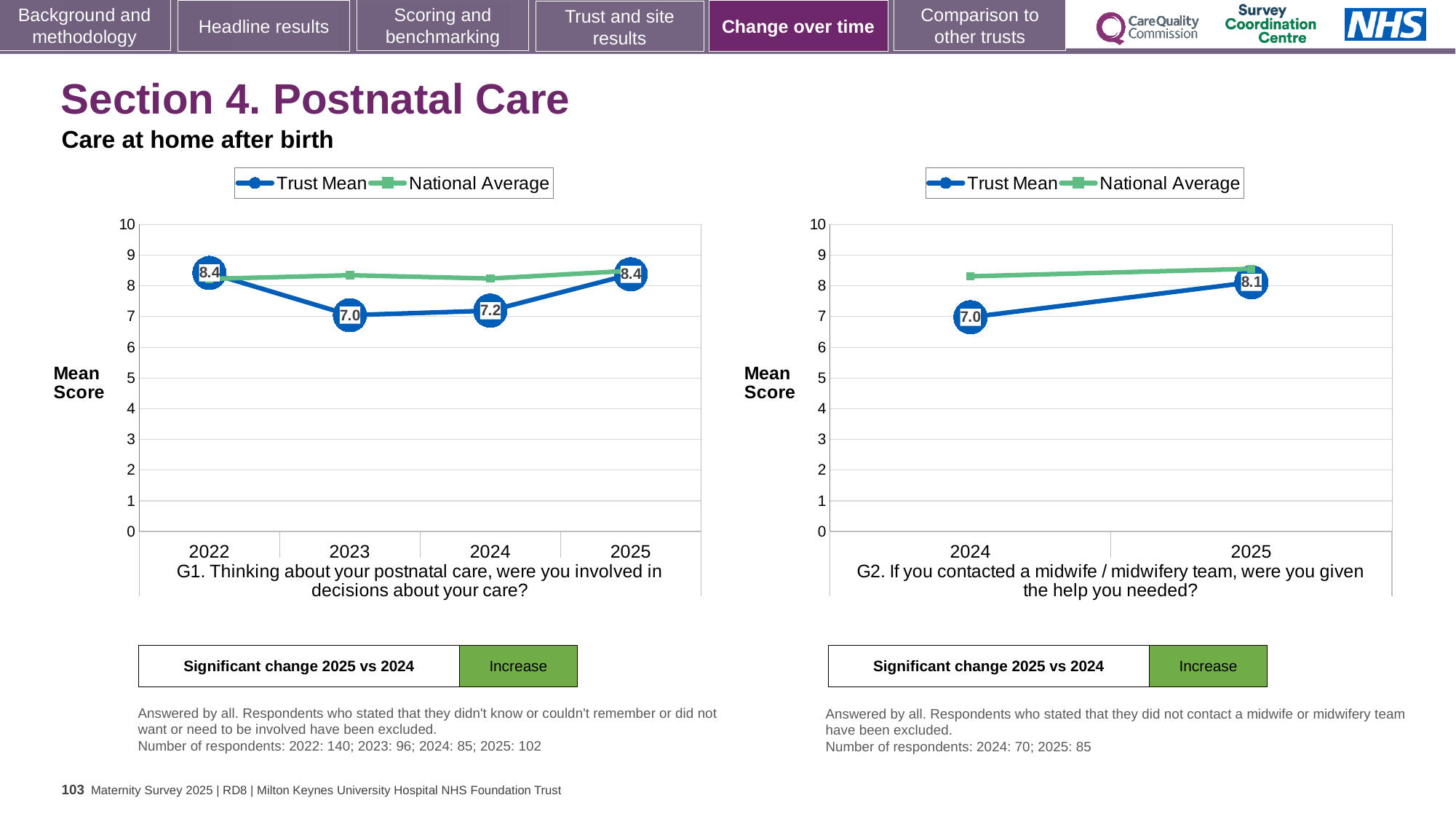
How many years are shown on the x axis of the G1 chart (left)? 4 In the G1 chart (left), what is the Trust Mean score for 2025? 8.4 How many series does the legend of the G2 chart (right) list? 2 In the G1 chart (left), is the Trust Mean for 2022 or for 2024 higher? 2022 In the G2 chart (right), is the National Average for 2024 greater or less than 8? greater In the G1 chart (left), which year has the lowest Trust Mean score? 2023 In the G1 chart (left), what is the difference between the Trust Mean scores for 2025 and 2024? 1.2 In the G2 chart (right), what is the difference between the Trust Mean scores for 2025 and 2024? 1.1 In the G1 chart (left), what is the Trust Mean score for 2023? 7.0 In the G2 chart (right), what is the Trust Mean score for 2024? 7.0 What type of chart is the G1 chart (left)? Line chart In the G2 chart (right), what is the Trust Mean score for 2025? 8.1